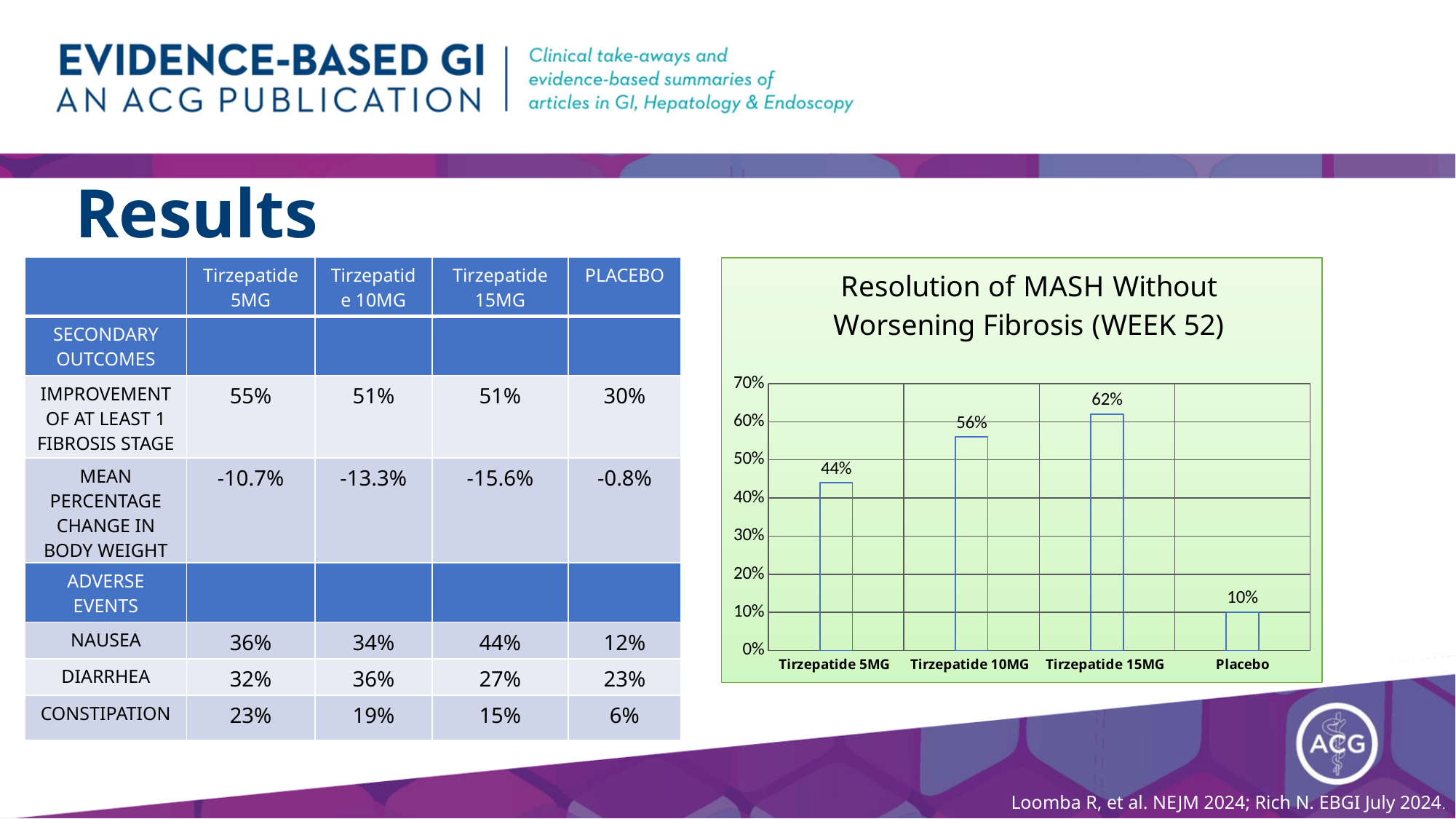
What is the value for Placebo in the chart? 10% What is the value for Tirzepatide 10MG in the chart? 56% What kind of chart is shown on the slide? Bar chart What is the title of the chart? Resolution of MASH Without Worsening Fibrosis (WEEK 52) What is the difference between the values for Tirzepatide 15MG and Placebo? 52% How many categories are shown in the chart? 4 Which category has the lowest value in the chart? Placebo What is the value for Tirzepatide 5MG in the chart? 44% What is the value for Tirzepatide 15MG in the chart? 62% Which category has the highest value in the chart? Tirzepatide 15MG What is the difference between the values for Tirzepatide 10MG and Tirzepatide 5MG? 12% Which is larger, the value for Tirzepatide 10MG or Tirzepatide 5MG? Tirzepatide 10MG